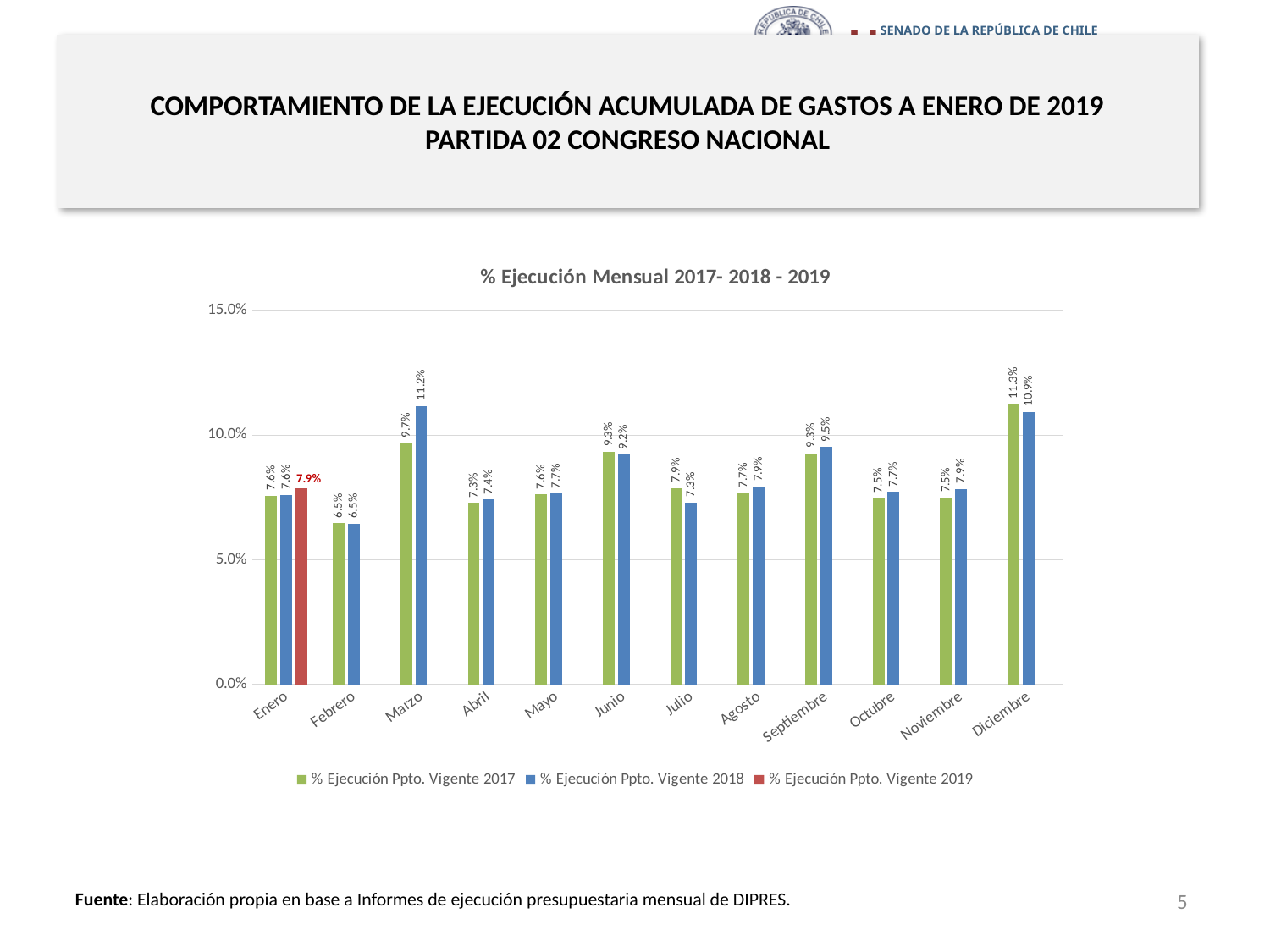
Which month has the highest value for % Ejecución Ppto. Vigente 2017? Diciembre What is the value for % Ejecución Ppto. Vigente 2018 in Julio? 7.3% What is the title of the chart? % Ejecución Mensual 2017- 2018 - 2019 What is the difference between the 2018 and 2017 values in Marzo? 1.5% What kind of chart is shown on the slide? Bar chart In Julio, which series has the larger value, % Ejecución Ppto. Vigente 2017 or % Ejecución Ppto. Vigente 2018? % Ejecución Ppto. Vigente 2017 How many series does the legend list? 3 What is the value for % Ejecución Ppto. Vigente 2019 in Enero? 7.9% What is the value for % Ejecución Ppto. Vigente 2017 in Diciembre? 11.3% How many months are shown on the x axis? 12 What is the value for % Ejecución Ppto. Vigente 2018 in Marzo? 11.2% Which month has the lowest value for % Ejecución Ppto. Vigente 2018? Febrero